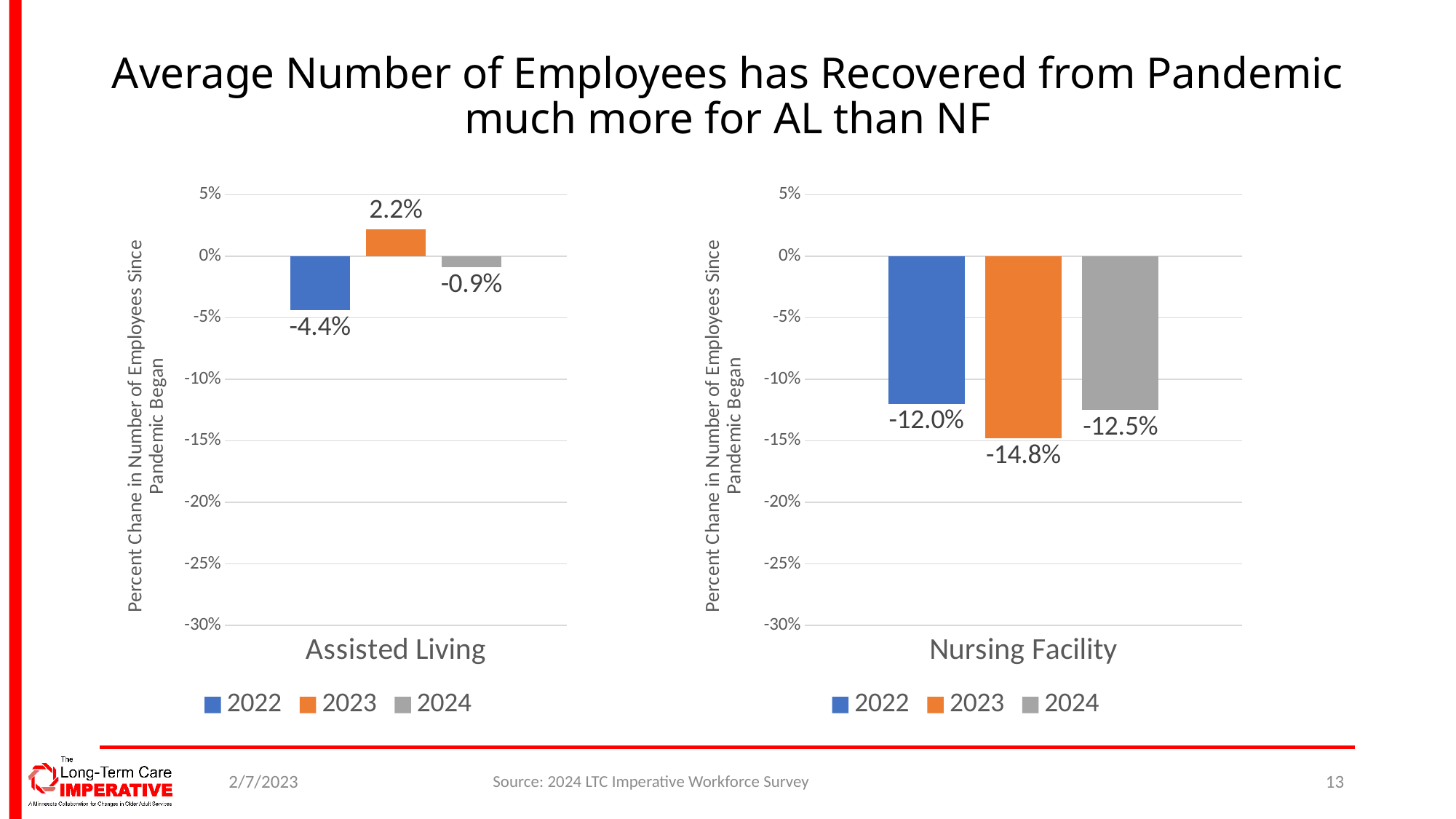
How many series does the legend of the Nursing Facility chart list? 3 In the Assisted Living chart, what is the value for 2023? 2.2% In the Nursing Facility chart, what is the value for 2024? -12.5% In the Nursing Facility chart, which year has the lowest value? 2023 In the Nursing Facility chart, what is the value for 2023? -14.8% In the Assisted Living chart, which is larger, the value for 2022 or the value for 2024? 2024 In the Assisted Living chart, what is the value for 2022? -4.4% In the Nursing Facility chart, is the value for 2022 greater or less than -10%? less In the Nursing Facility chart, what is the difference between the 2022 and 2023 values? 2.8 percentage points In the Assisted Living chart, which year has the highest value? 2023 What kind of chart is the Assisted Living chart? bar chart In the Assisted Living chart, what colour is the bar for 2023? orange